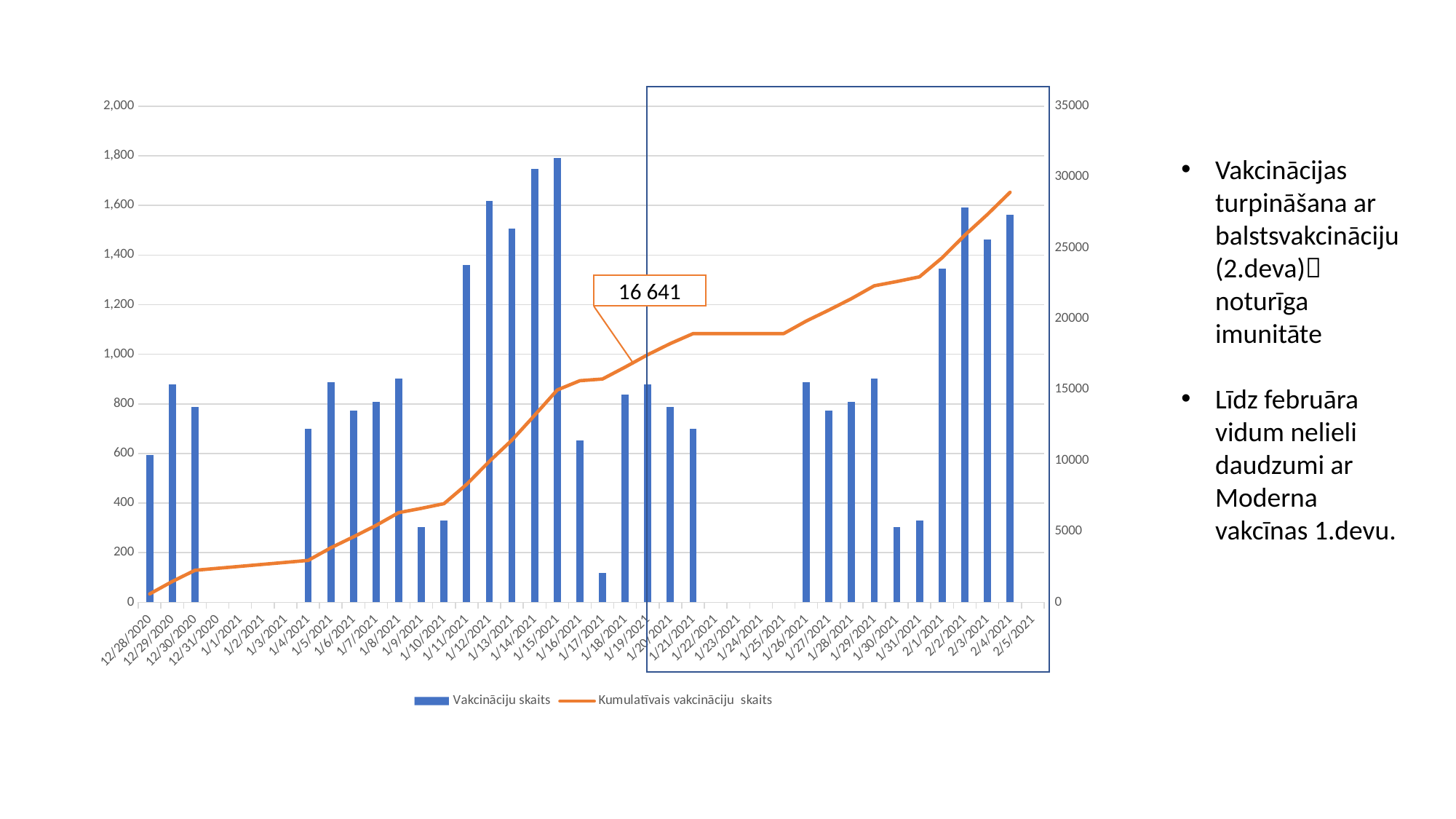
What value is shown in the data label on the cumulative vaccinations line? 16 641 Does the Kumulatīvais vakcināciju skaits line rise or fall along the x axis? rises What colour is the Kumulatīvais vakcināciju skaits line? Orange On which date is the Vakcināciju skaits bar the highest? 1/15/2021 Is the Vakcināciju skaits value for 1/30/2021 greater or less than 400? less Is the Vakcināciju skaits value for 1/11/2021 greater or less than 1,200? greater How many series does the chart legend list? 2 Which date has a larger Vakcināciju skaits bar, 2/2/2021 or 2/3/2021? 2/2/2021 Is the Vakcināciju skaits value for 1/15/2021 greater or less than 1,600? greater Which date has a larger Vakcināciju skaits bar, 1/12/2021 or 1/13/2021? 1/12/2021 What kind of chart is shown on the slide? Combination bar and line chart